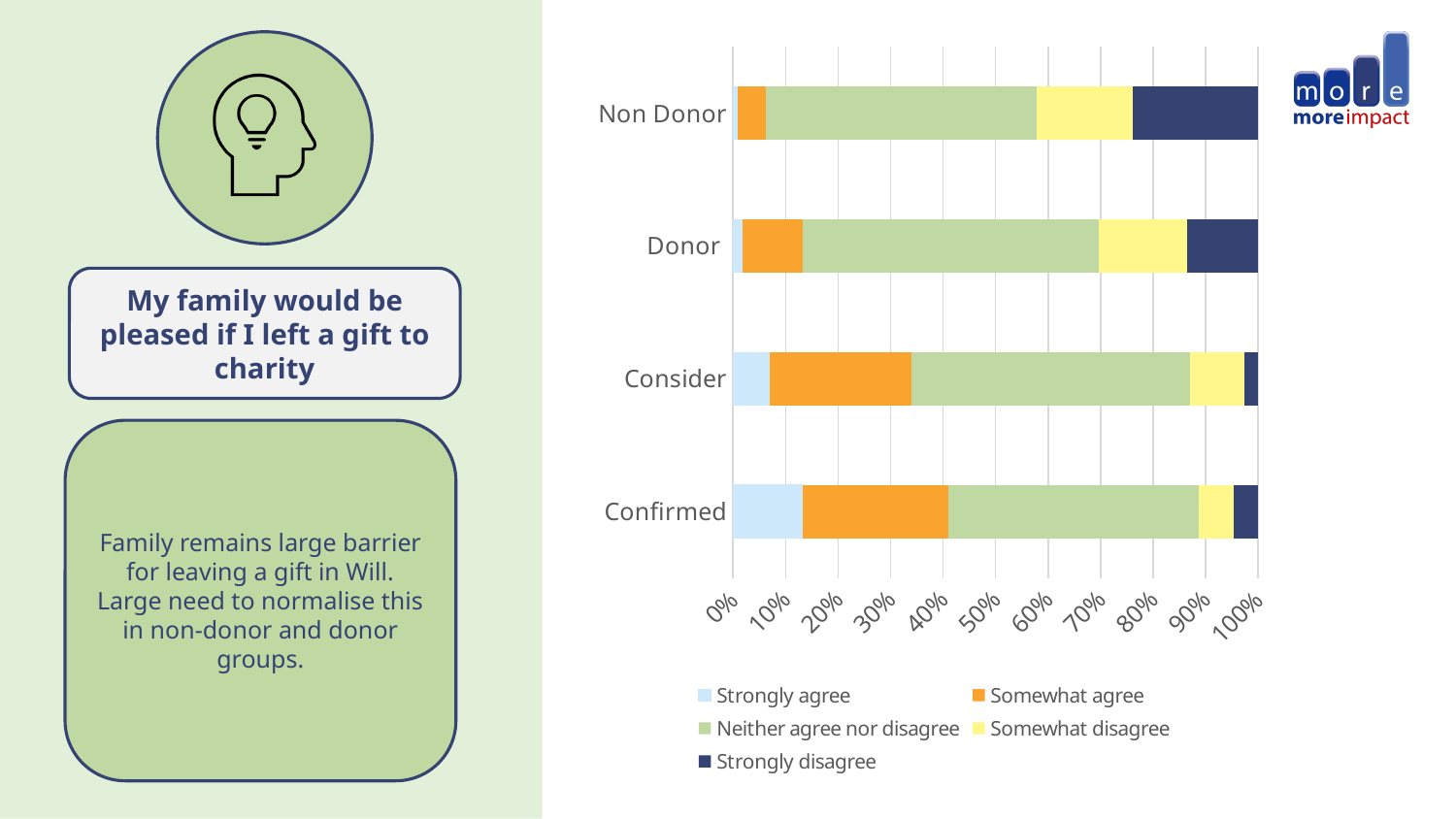
Is the 'Strongly disagree' value for Donor greater or less than 20%? less How many categories are shown on the vertical axis of the chart? 4 How many series does the chart's legend list? 5 Is the 'Strongly agree' value for Confirmed greater or less than 10%? greater Is the 'Somewhat agree' value for Consider greater or less than 20%? greater What colour represents 'Somewhat agree' in the chart's legend? Orange Which category has the smallest 'Somewhat agree' segment? Non Donor Which is larger: the 'Strongly disagree' segment for Non Donor or for Confirmed? Non Donor What kind of chart is shown on the slide? Stacked bar chart Which category has the largest 'Strongly agree' segment? Confirmed Which category has the largest 'Strongly disagree' segment? Non Donor